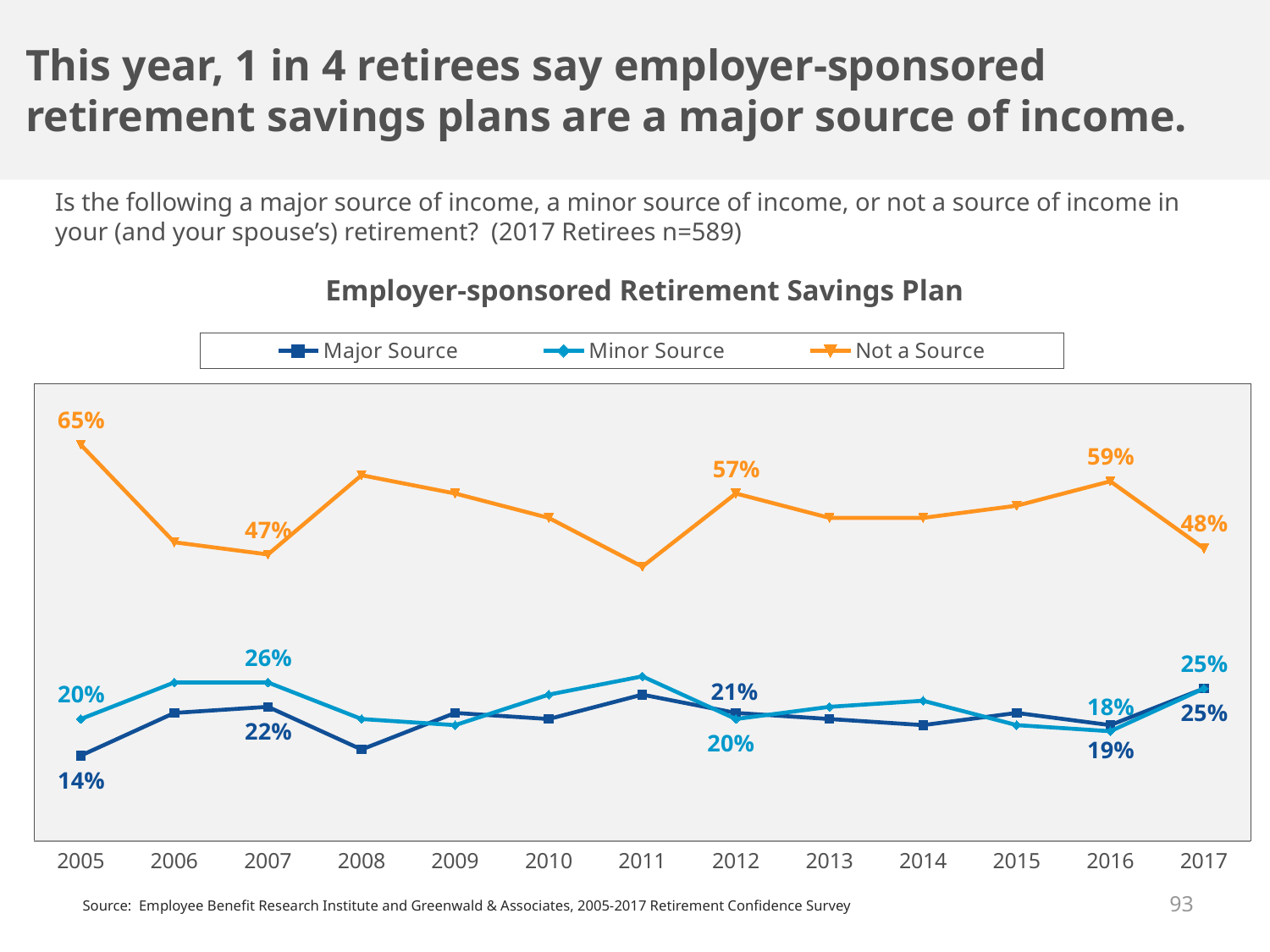
How many years are shown on the x axis? 13 What is the value for Major Source in 2017? 25% What kind of chart is shown on the slide? line chart What is the value for Not a Source in 2016? 59% What is the value for Major Source in 2005? 14% What is the value for Minor Source in 2007? 26% What is the difference between the Not a Source values in 2016 and 2017? 11% What is the value for Not a Source in 2005? 65% Which series has the highest value in 2017? Not a Source How many series does the legend list? 3 What is the title of the chart? Employer-sponsored Retirement Savings Plan Which is larger in 2012, Major Source or Not a Source? Not a Source